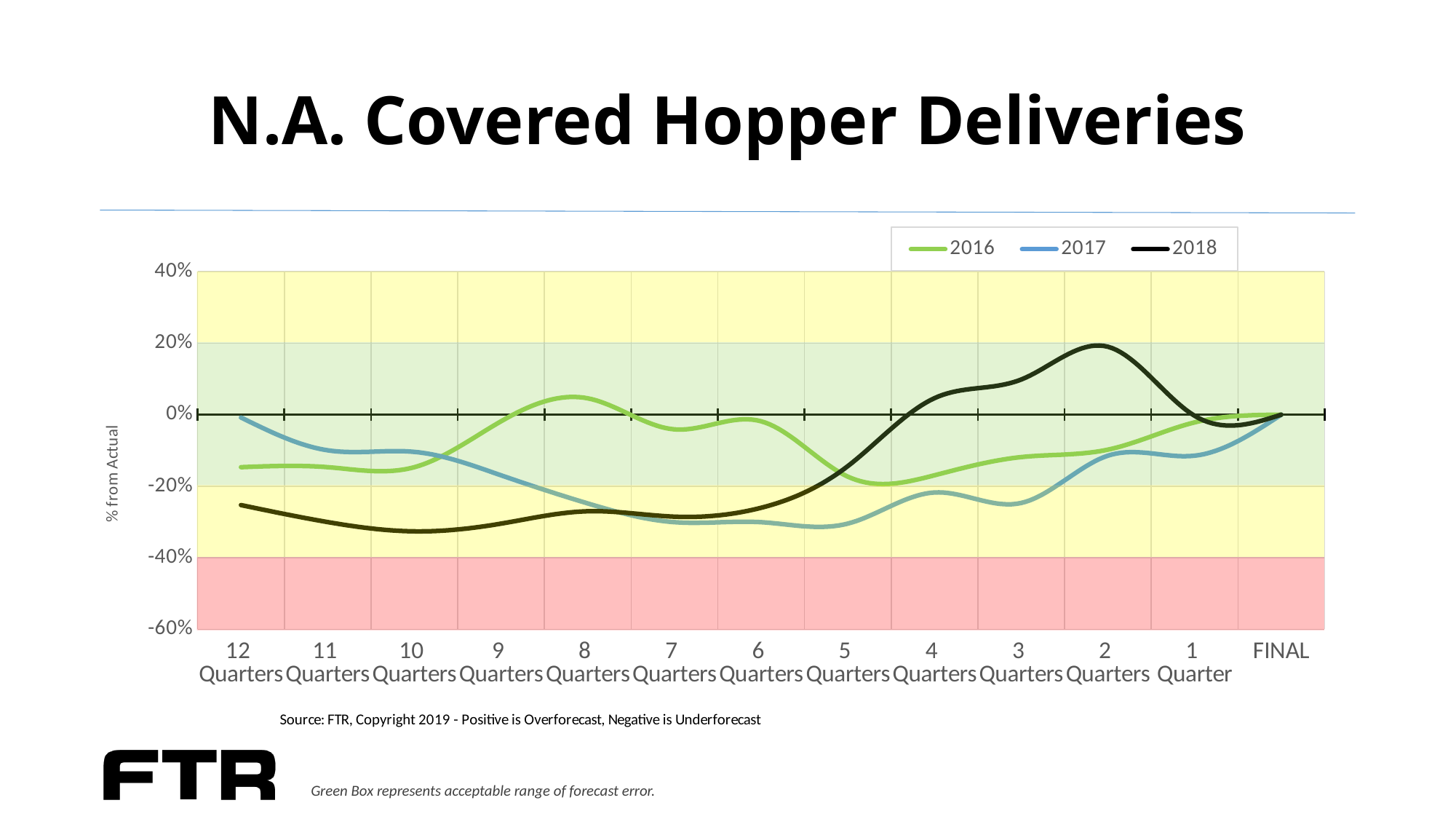
Is the value for 2018 at 2 Quarters greater or less than 0%? greater At 2 Quarters, which series has the larger value, 2017 or 2018? 2018 At 10 Quarters, which series has the larger value, 2017 or 2018? 2017 What kind of chart is shown on the slide? line chart How many points are labelled along the x axis? 13 Which series has the lowest value at 10 Quarters? 2018 Does the 2018 line rise or fall from 12 Quarters to 2 Quarters? rise What is the label on the y axis? % from Actual How many series does the legend list? 3 Is the value for 2017 at 6 Quarters greater or less than -20%? less Is the value for 2018 at 12 Quarters greater or less than -20%? less